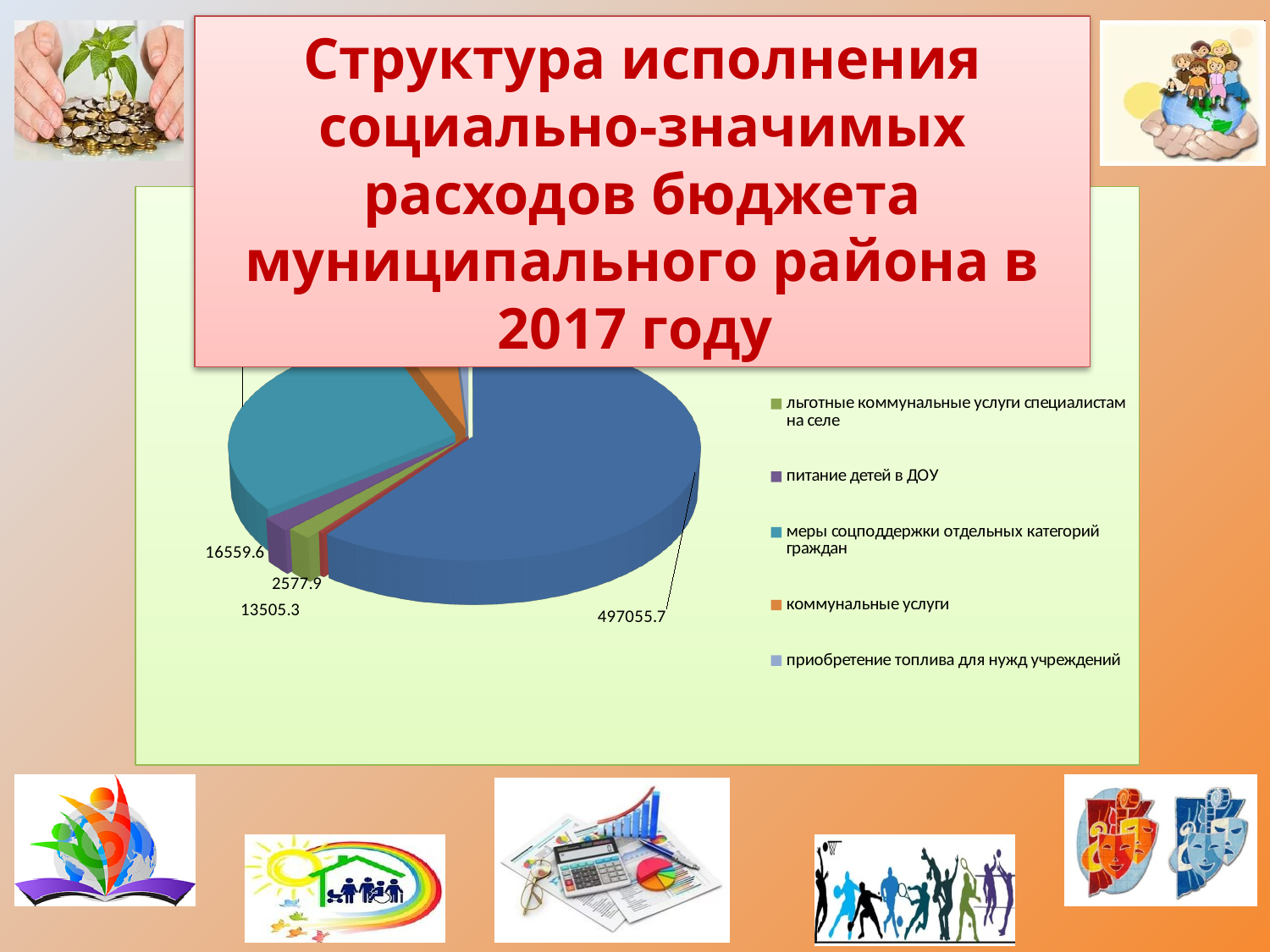
What is the value printed on the largest slice of the pie chart? 497055.7 What is the smallest value printed as a data label on the pie chart? 2577.9 Does the largest slice of the pie chart take up more or less than half of the pie? more Which is larger, the slice labelled 16559.6 or the slice labelled 13505.3? 16559.6 What is the difference between the data labels 13505.3 and 2577.9 on the pie chart? 10927.4 What kind of chart is shown on the slide? pie chart What is the difference between the data labels 16559.6 and 13505.3 on the pie chart? 3054.3 What colour is the legend marker for 'коммунальные услуги'? orange What colour is the legend marker for 'питание детей в ДОУ'? purple